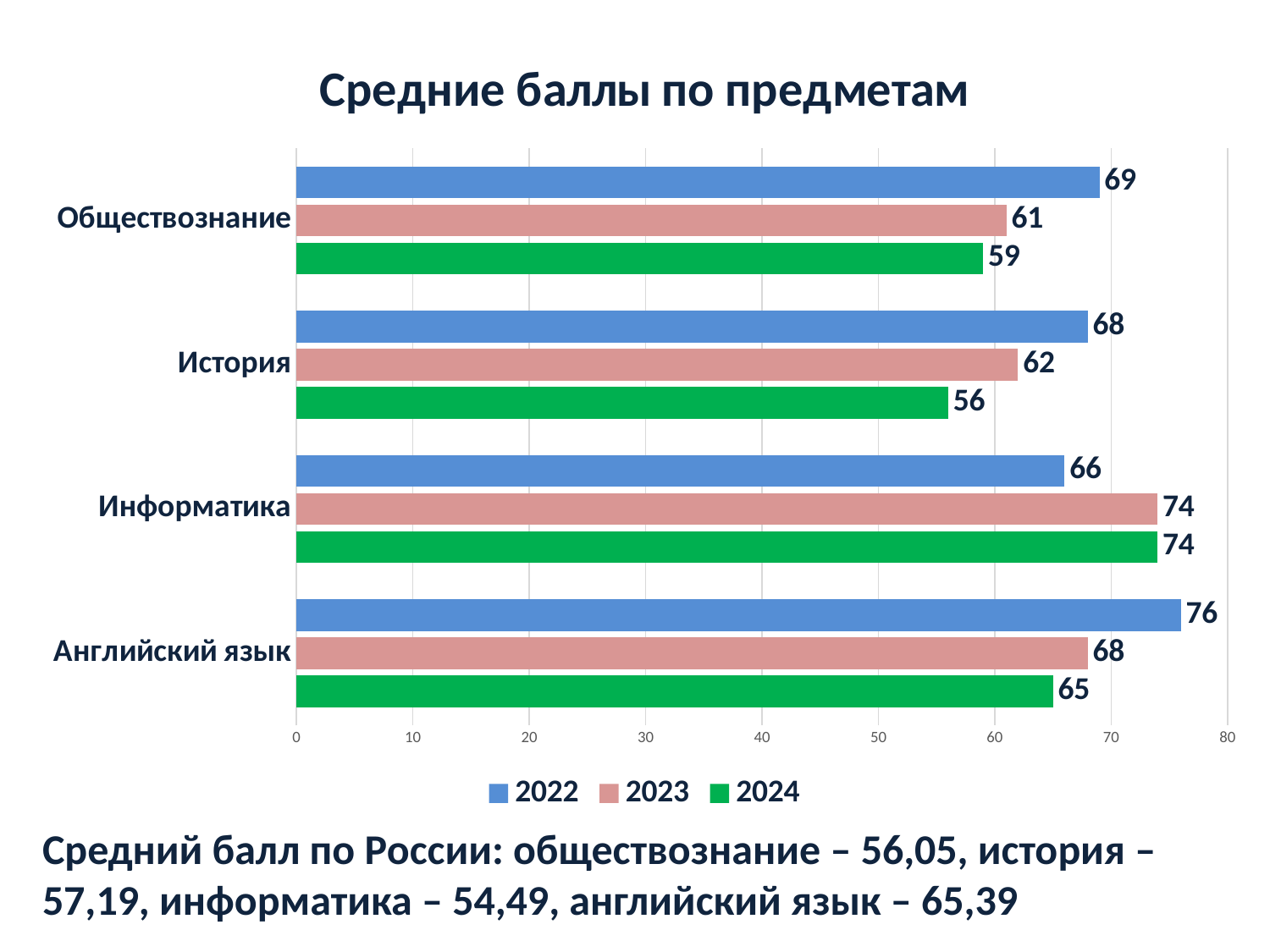
Which subject has the highest value in 2022? Английский язык What is the difference between the 2022 and 2024 values for История? 12 Which subject has the lowest value in 2024? История How many series does the legend list? 3 What is the value for Информатика in 2023? 74 How many subjects are shown on the chart? 4 What is the value for История in 2024? 56 Which is larger for Информатика: the 2022 value or the 2023 value? 2023 What is the title of the chart? Средние баллы по предметам What is the value for Обществознание in 2022? 69 What kind of chart is shown on the slide? Bar chart What is the value for Английский язык in 2022? 76